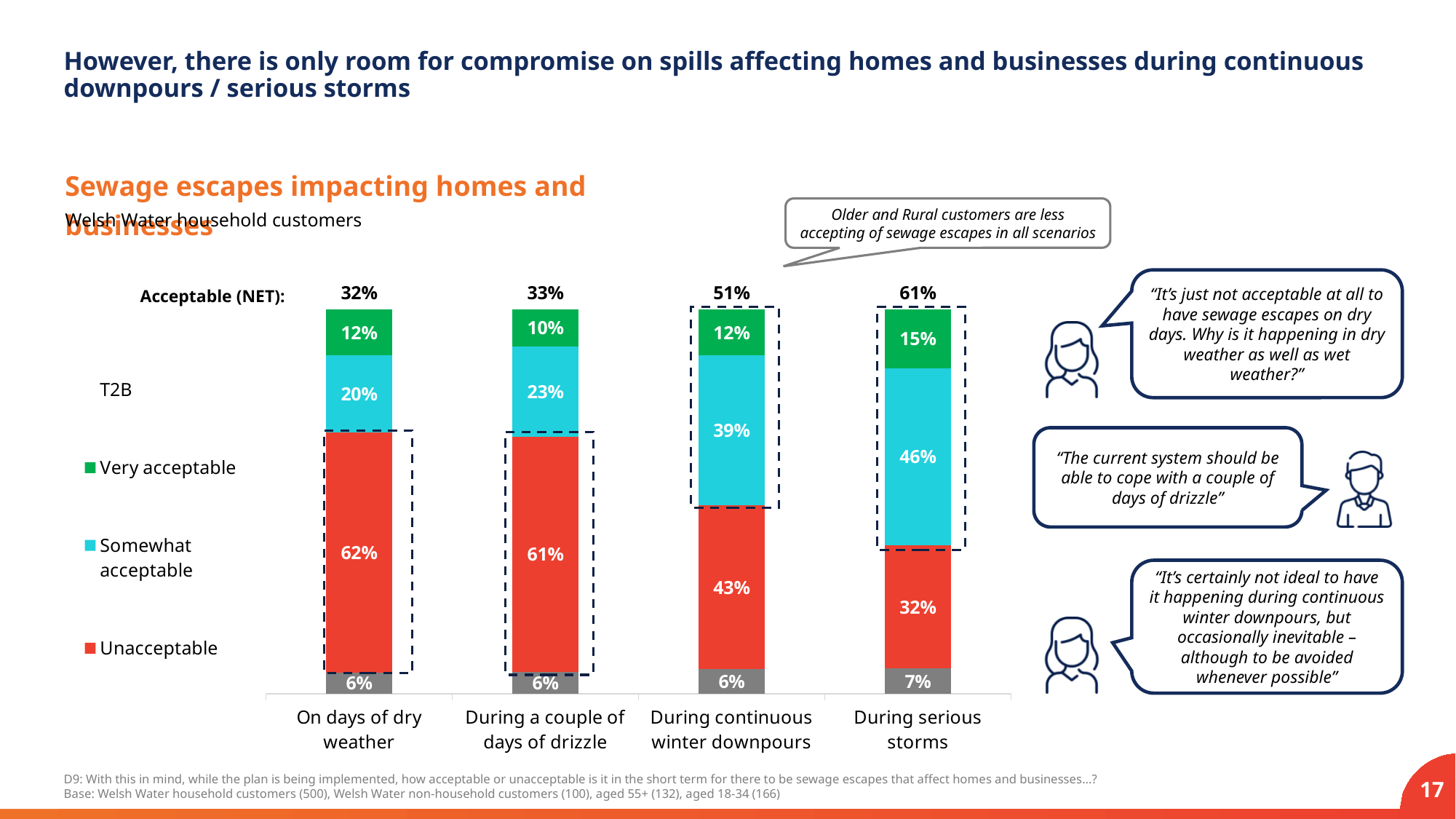
Which scenario has the lowest 'Unacceptable' value? During serious storms What is the 'Very acceptable' value for 'During a couple of days of drizzle'? 10% What is the difference between the 'Unacceptable' values for 'On days of dry weather' and 'During serious storms'? 30% What is the Acceptable (NET) figure for 'During continuous winter downpours'? 51% How many series does the chart legend list? 3 How many scenarios (categories) are shown on the x axis of the chart? 4 What type of chart is used to show the sewage escape acceptability data? Stacked bar chart What is the 'Somewhat acceptable' value for 'During serious storms'? 46% What percentage of Welsh Water household customers said sewage escapes on days of dry weather are unacceptable? 62% Does the Acceptable (NET) figure rise or fall moving from 'On days of dry weather' to 'During serious storms'? Rise Which scenario has the highest Acceptable (NET) figure? During serious storms Which is larger: the 'Somewhat acceptable' value for 'During continuous winter downpours' or for 'During a couple of days of drizzle'? During continuous winter downpours